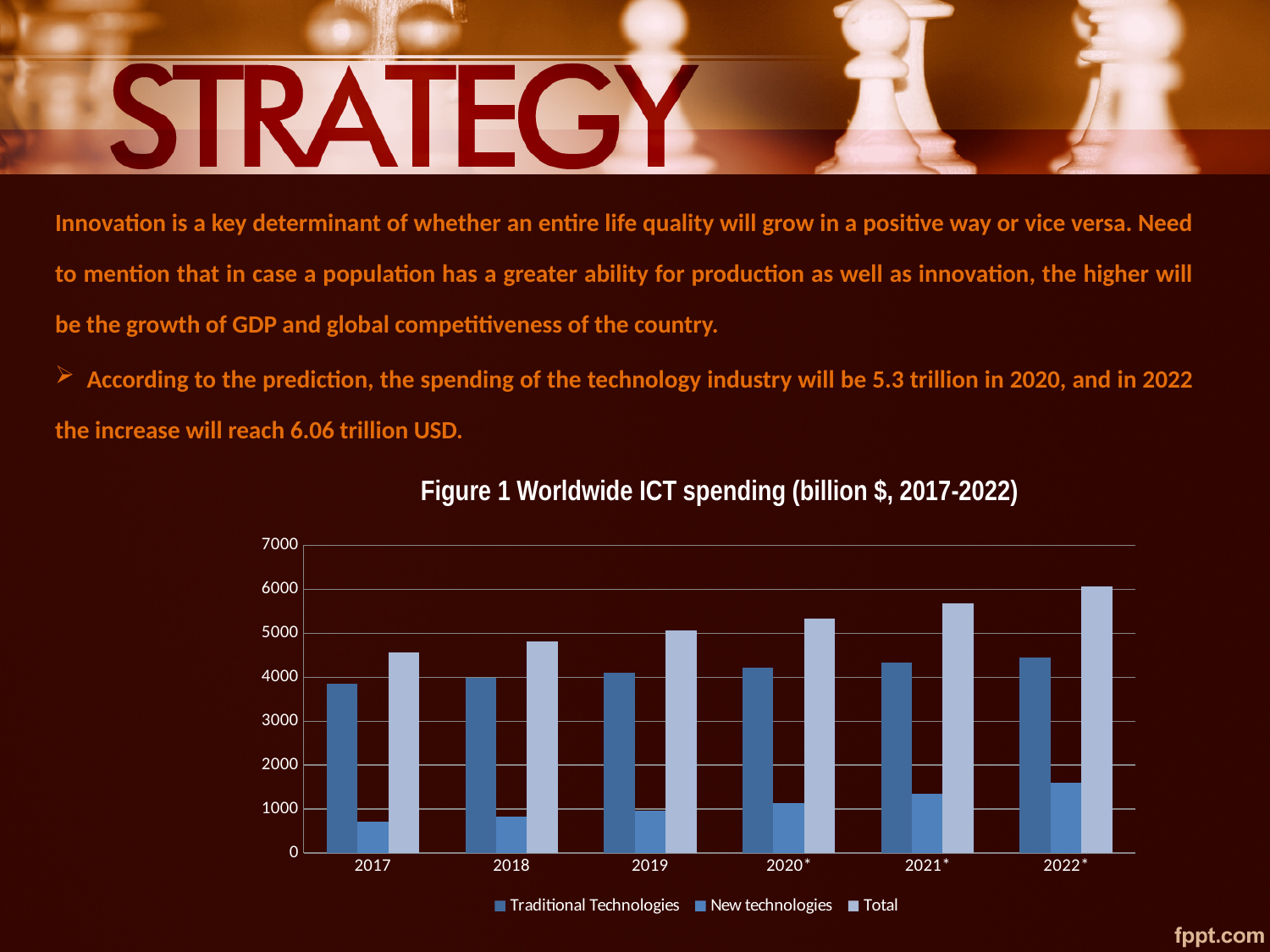
Which is larger in 2019, the Traditional Technologies value or the New technologies value? Traditional Technologies What type of chart is shown on the slide? bar chart Do the Total values rise or fall from 2017 to 2022*? rise How many series does the legend list? 3 How many year categories are shown on the x axis? 6 Is the New technologies value for 2017 greater or less than 1000? less Is the Total value for 2017 greater or less than 5000? less Is the Total value for 2021* greater or less than 5000? greater What is the title of the chart? Figure 1 Worldwide ICT spending (billion $, 2017-2022) In which year is the New technologies bar lowest? 2017 In which year is the Total bar highest? 2022*